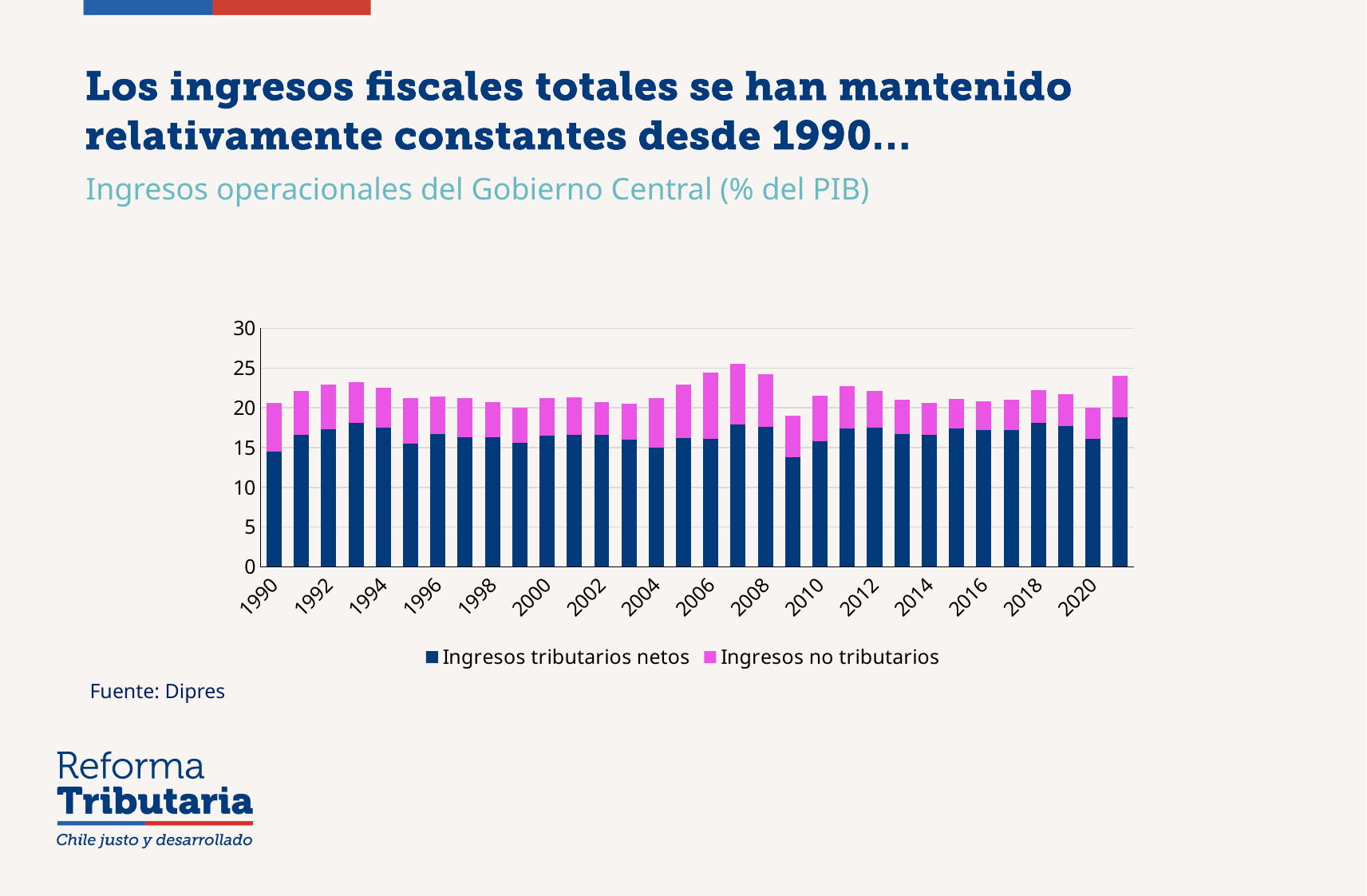
Is the total revenue for 2009 greater or less than 20? less In which year is the total bar (tax plus non-tax revenue) the lowest? 2009 What kind of chart is shown on the slide? Stacked bar chart Is the value of Ingresos tributarios netos for 2021 greater or less than 15? greater Which year has the larger total revenue, 2007 or 2009? 2007 What are the two series named in the legend? Ingresos tributarios netos; Ingresos no tributarios In which year is the total bar (tax plus non-tax revenue) the highest? 2007 Is the total revenue for 2006 greater or less than 20? greater How many series does the legend list? 2 What is the subtitle describing the chart's measure? Ingresos operacionales del Gobierno Central (% del PIB) Between 2007 and 2009, did total revenue rise or fall? fall